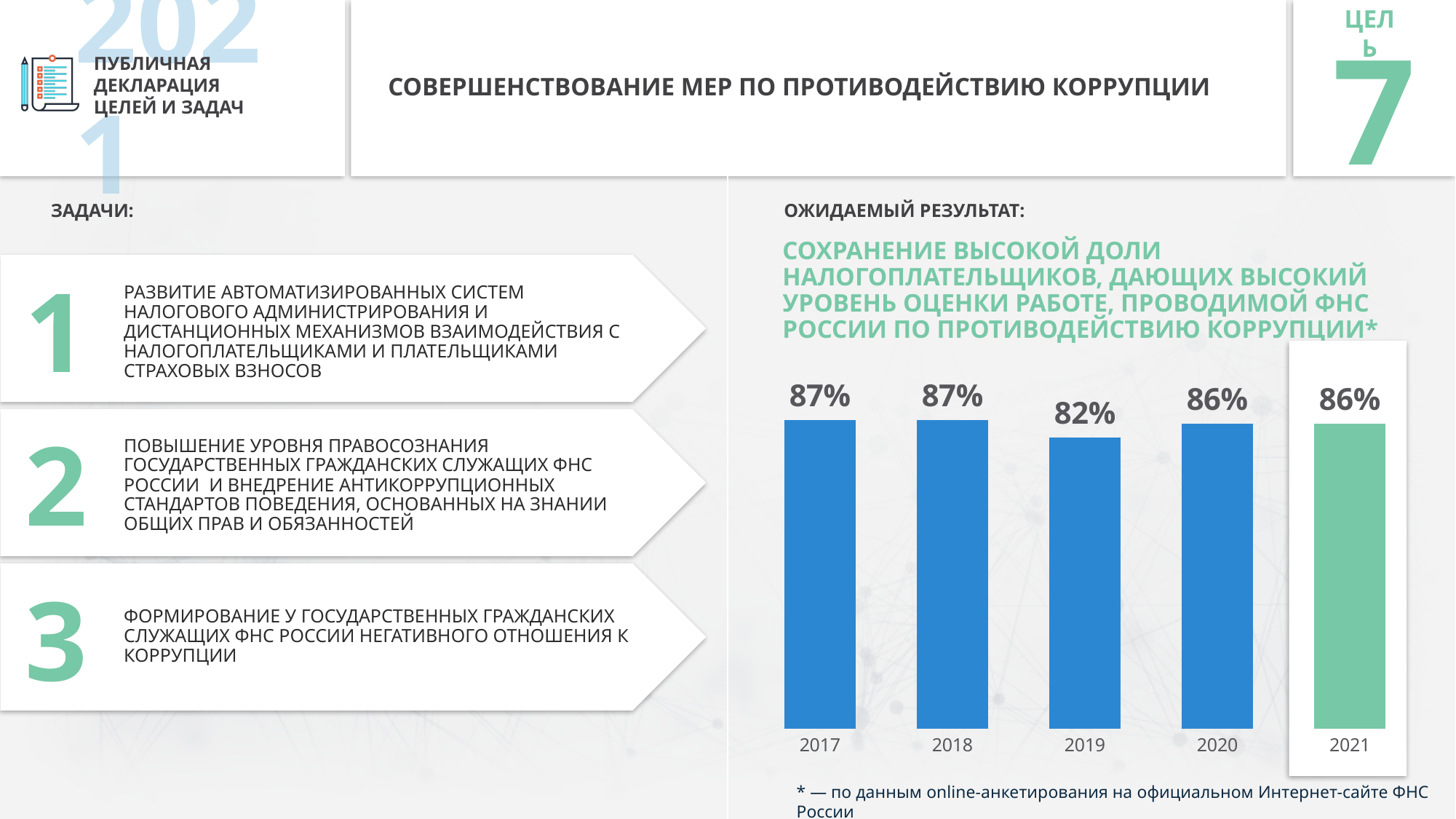
Do the values for 2017 and 2018 differ? No, both are 87% How many years are shown on the x axis of the chart? 5 What is the difference between the values for 2018 and 2019? 5 percentage points Does the value rise or fall from 2018 to 2019? Fall Which year's bar is coloured green rather than blue? 2021 Which is larger, the value for 2019 or the value for 2020? 2020 What is the value shown for 2019? 82% Which year has the lowest value in the chart? 2019 What is the value shown for 2021? 86% What kind of chart is shown on the slide? Bar chart What is the value shown for 2017? 87% What is the value shown for 2020? 86%